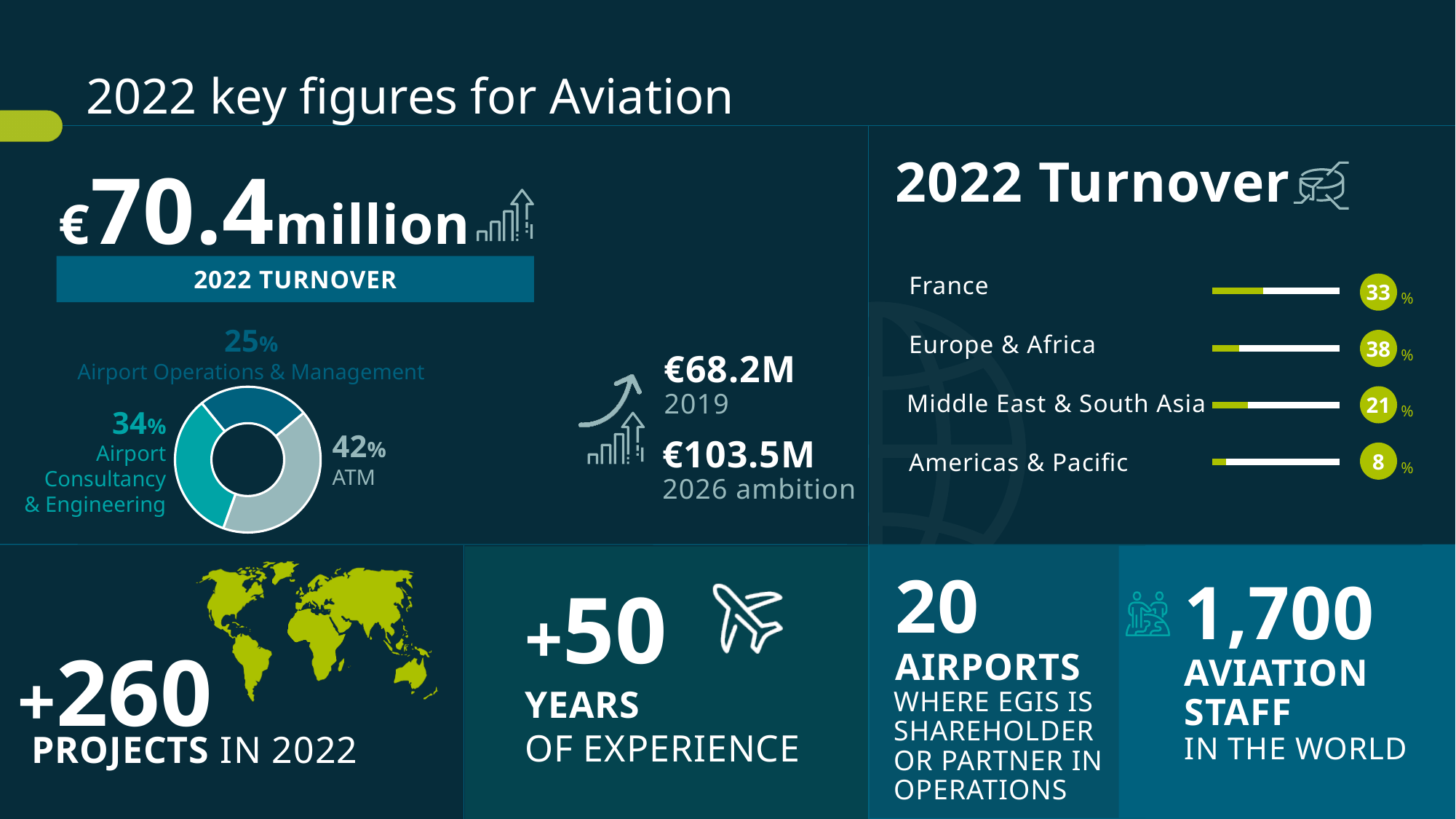
In the donut chart on the left, what share of turnover is ATM? 42% In the donut chart on the left, which segment has the smallest share? Airport Operations & Management In the donut chart on the left, which segment has the largest share? ATM In the donut chart on the left, what share of turnover is Airport Operations & Management? 25% In the 2022 Turnover chart on the right, what is the value for Middle East & South Asia? 21% In the donut chart on the left, what share of turnover is Airport Consultancy & Engineering? 34% In the 2022 Turnover chart on the right, how many regions are listed? 4 In the donut chart on the left, how many segments are shown? 3 In the 2022 Turnover chart on the right, which region has the highest share? Europe & Africa In the 2022 Turnover chart on the right, what is the value for France? 33% In the 2022 Turnover chart on the right, which region has the lowest share? Americas & Pacific In the donut chart on the left, what is the difference in percentage points between ATM and Airport Consultancy & Engineering? 8